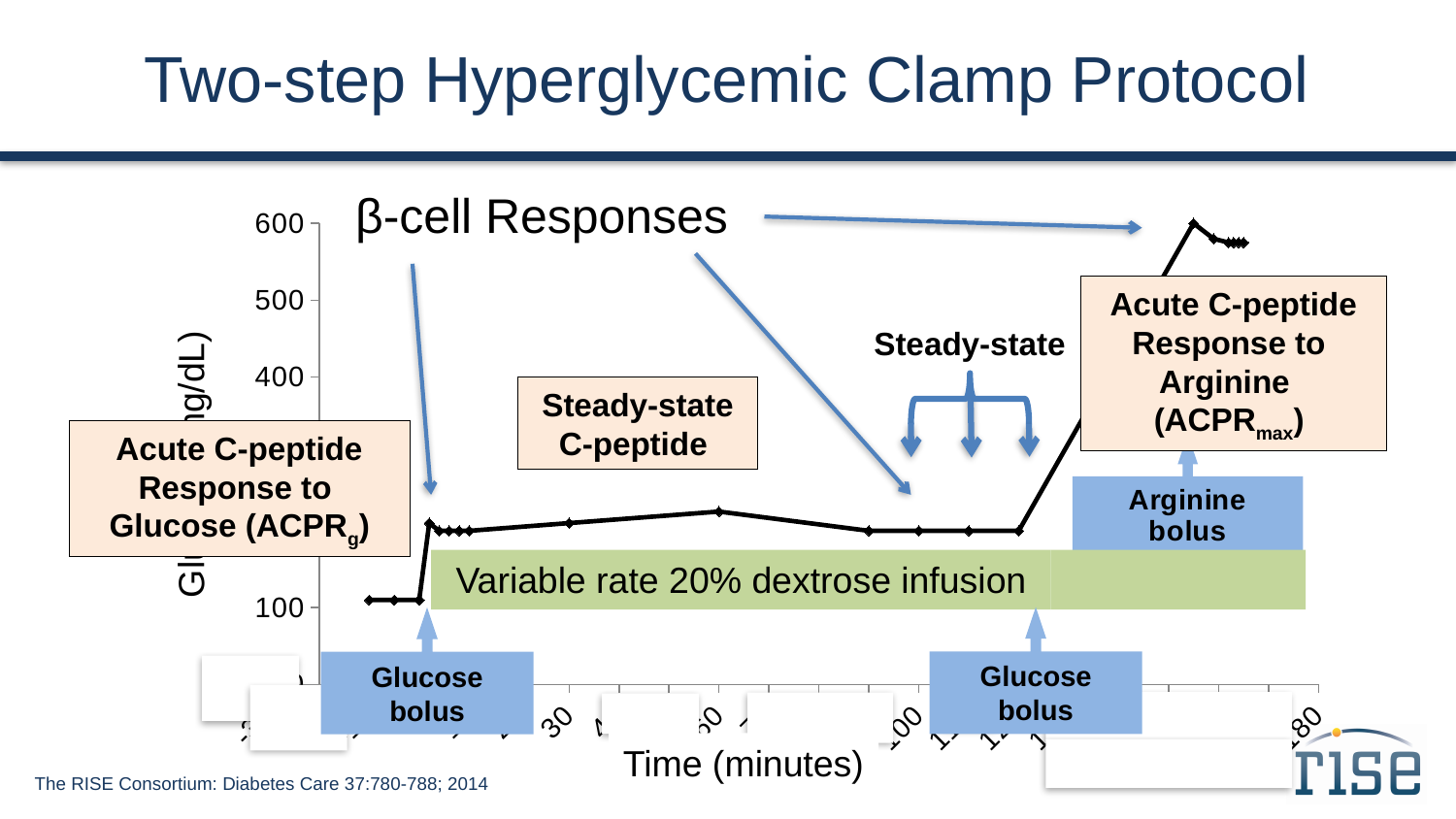
What kind of chart is shown on the slide? line chart Does the plotted line rise or fall after the second glucose bolus? rise Is the peak value of the plotted line, reached after the arginine bolus, greater or less than 500? greater Is the value of the plotted line at the start of the protocol, before the first glucose bolus, greater or less than 400? less Does the plotted line rise or fall immediately after the first glucose bolus? rise Which is larger: the value of the plotted line at the end of the protocol (after the arginine bolus) or the value during the steady-state period? the value after the arginine bolus Is the value of the plotted line during the steady-state period (between the two glucose boluses) greater or less than 400? less Which is larger: the value of the plotted line before the first glucose bolus or the value during the steady-state period? the value during the steady-state period What is the highest tick value shown on the y axis of the chart? 600 What is the title of the x axis of the chart? Time (minutes)